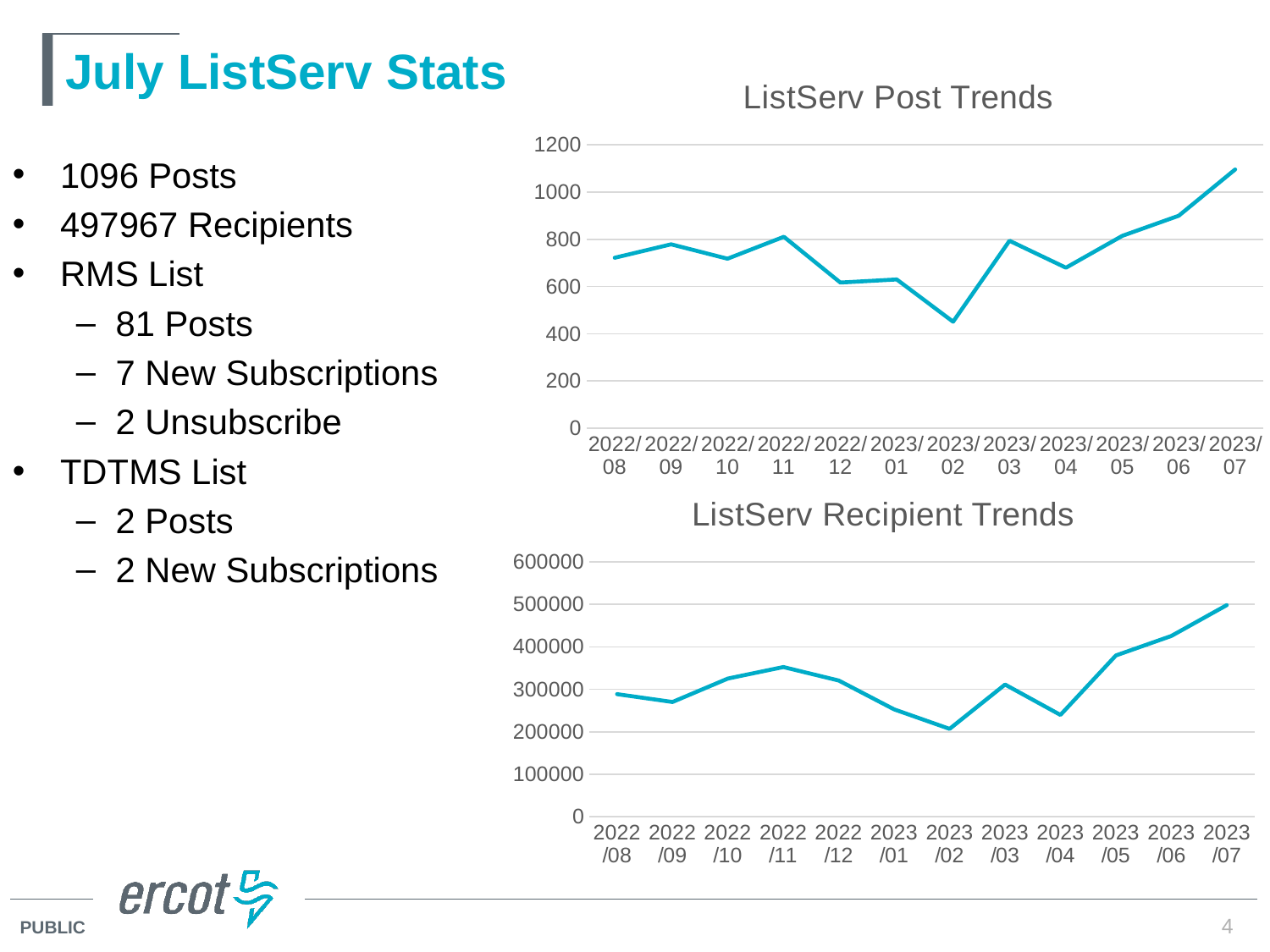
How many data points are plotted on the ListServ Post Trends chart? 12 On the ListServ Post Trends chart, is the value for 2023/07 greater or less than 1000? greater On the ListServ Recipient Trends chart, do the values rise or fall from 2023/02 to 2023/03? rise What is the title of the lower chart on the slide? ListServ Recipient Trends On the ListServ Post Trends chart, which is larger, the value for 2023/03 or the value for 2023/04? 2023/03 What kind of chart is the ListServ Post Trends chart? line chart On the ListServ Recipient Trends chart, which month has the highest value? 2023/07 On the ListServ Post Trends chart, which month has the highest value? 2023/07 On the ListServ Recipient Trends chart, which month has the lowest value? 2023/02 On the ListServ Post Trends chart, is the value for 2023/02 greater or less than 600? less On the ListServ Post Trends chart, which month has the lowest value? 2023/02 On the ListServ Recipient Trends chart, is the value for 2023/07 greater or less than 400000? greater